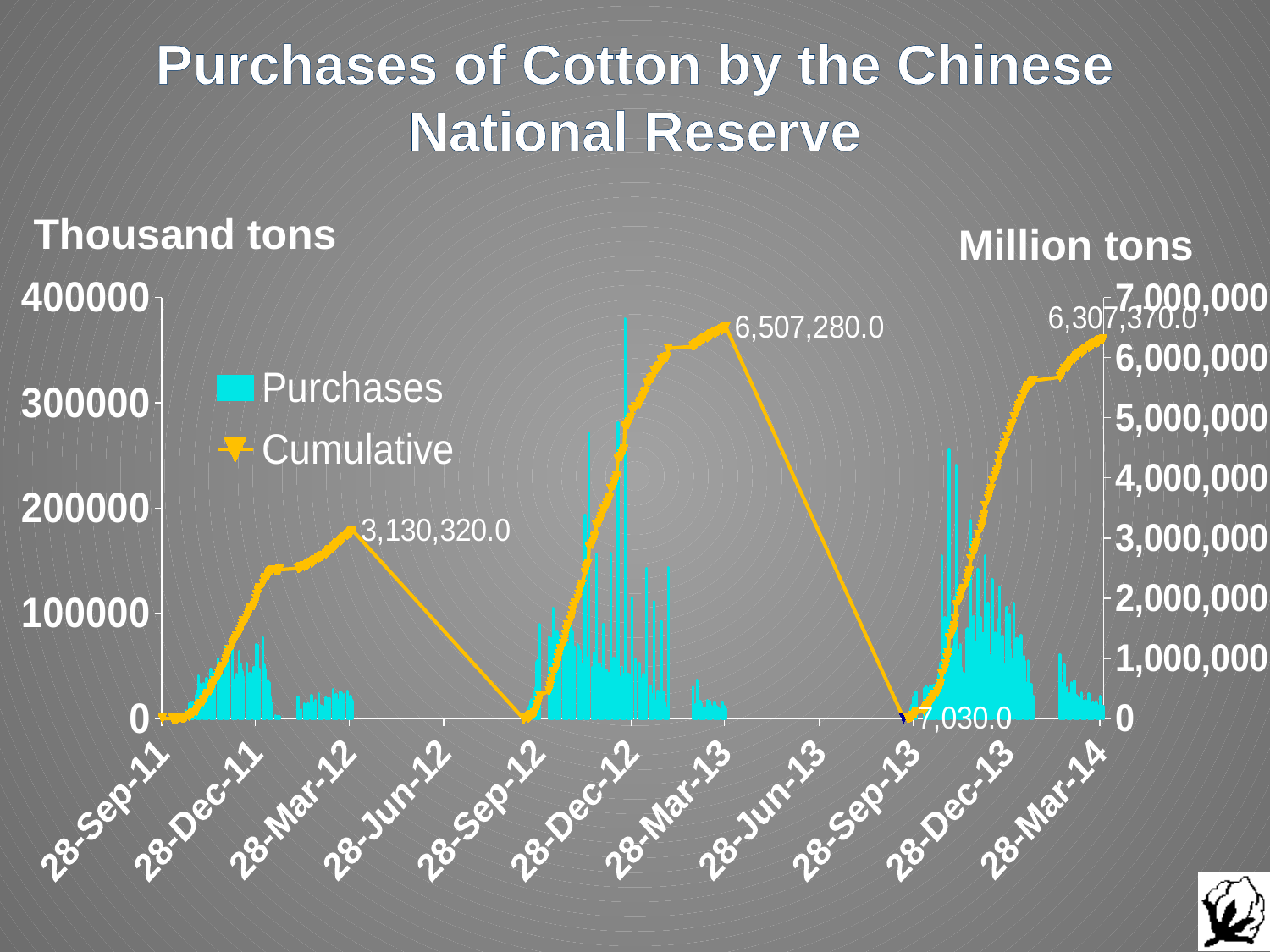
Which is larger: the Cumulative label near 28-Mar-13 or the Cumulative label near 28-Mar-14? 28-Mar-13 (6,507,280.0) What is the data label on the Cumulative line at its peak around 28-Mar-13? 6,507,280.0 What is the difference between the labeled Cumulative peaks 6,507,280.0 and 3,130,320.0? 3,376,960.0 What is the data label on the Cumulative line at its low point near 28-Sep-13? 7,030.0 Which labeled Cumulative value is the highest on the chart? 6,507,280.0 What kind of chart is shown on the slide? Combination bar and line chart What is the title of the chart? Purchases of Cotton by the Chinese National Reserve Which labeled Cumulative value is the lowest on the chart? 7,030.0 Is the tallest Purchases bar, around December 2012, greater or less than 300000 on the left axis? greater What is the data label on the Cumulative line at the right end of the chart, near 28-Mar-14? 6,307,370.0 How many series does the legend list? 2 What is the data label on the Cumulative line at its first peak, around 28-Mar-12? 3,130,320.0